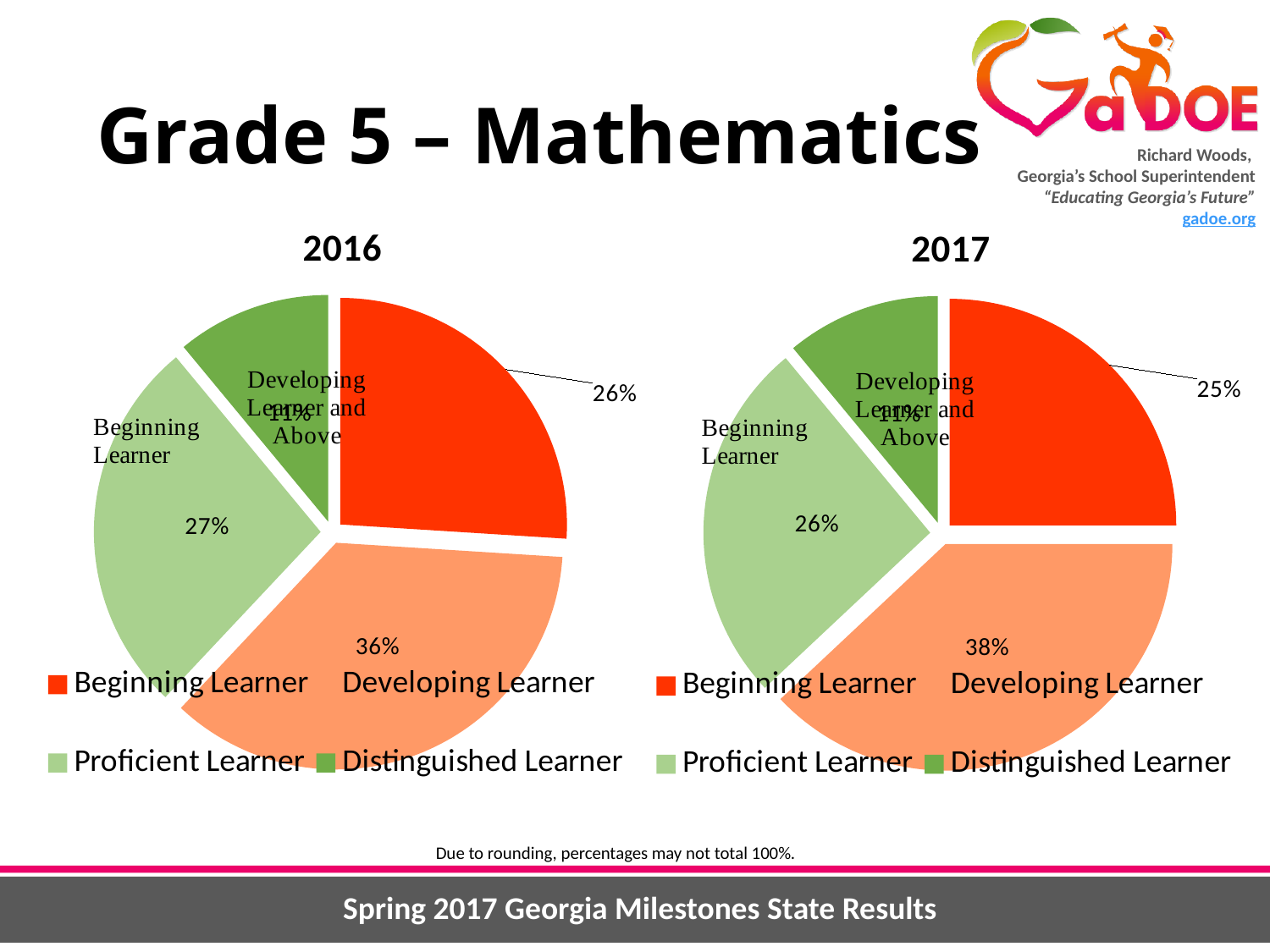
In the 2016 chart, what percentage is shown for Beginning Learner? 26% In the 2017 chart, what percentage is shown for Proficient Learner? 26% In the 2016 chart, which is larger: Proficient Learner or Beginning Learner? Proficient Learner In the 2016 chart, which category has the smallest slice? Distinguished Learner How many entries does the legend of the 2016 chart list? 4 What is the difference between the Developing Learner percentages in the 2017 chart and the 2016 chart? 2% What type of chart is used to show the 2016 results? Pie chart What colour represents Beginning Learner in the legend of the 2017 chart? Red In the 2017 chart, what percentage is shown for Developing Learner? 38% In the 2016 chart, what percentage is shown for Developing Learner? 36% How many slices does the 2017 pie chart have? 4 In the 2017 chart, which category has the largest slice? Developing Learner